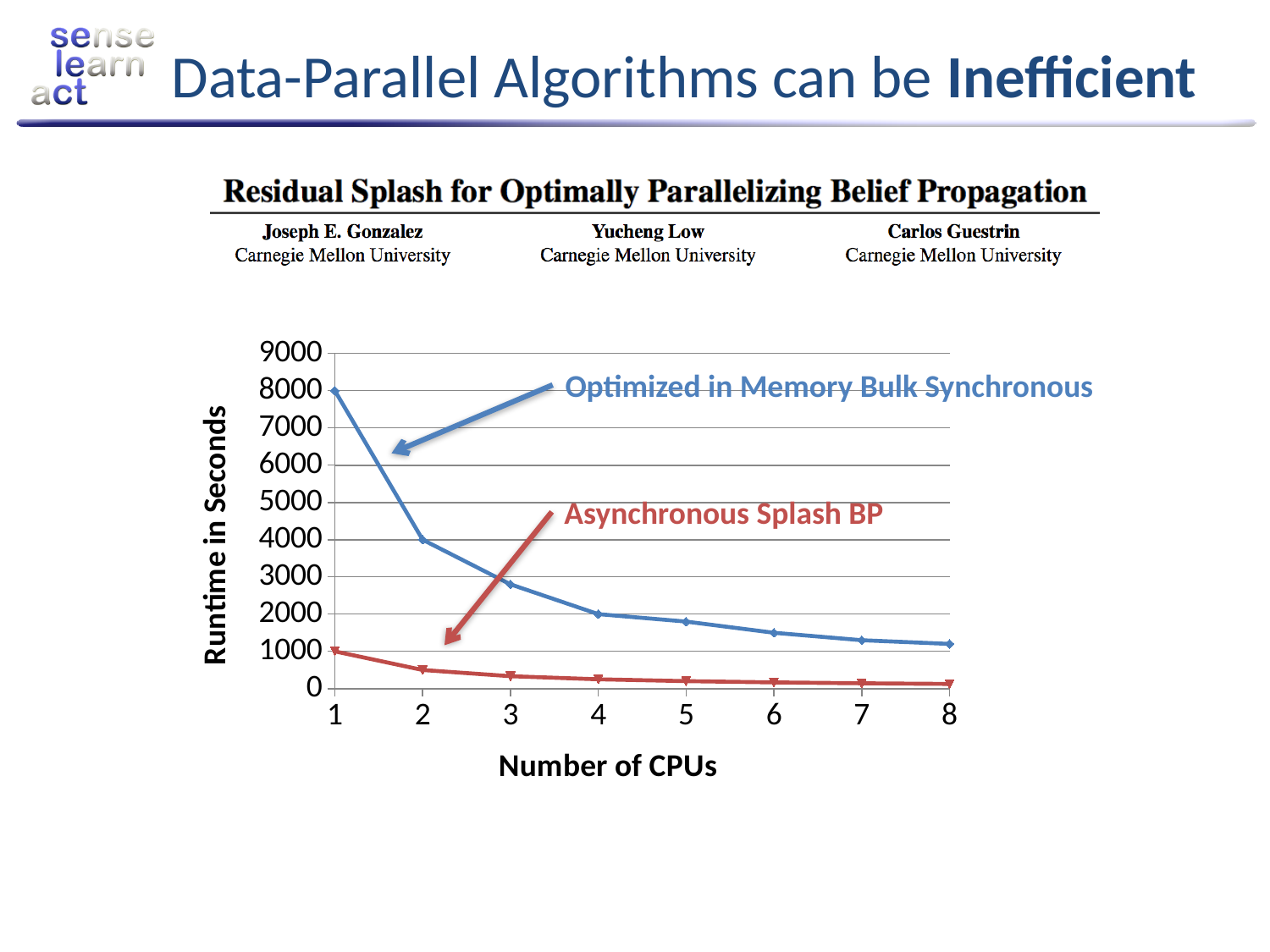
What kind of chart is shown on the slide? line chart Does the runtime for Optimized in Memory Bulk Synchronous rise or fall as the number of CPUs increases? fall How many CPU counts are shown along the x axis of the chart? 8 Is the runtime for Optimized in Memory Bulk Synchronous at 3 CPUs greater or less than 2000 seconds? greater What is the runtime in seconds for Optimized in Memory Bulk Synchronous at 1 CPU? 8000 Is the runtime for Asynchronous Splash BP at 2 CPUs greater or less than 1000 seconds? less At 4 CPUs, which series has the higher runtime, Optimized in Memory Bulk Synchronous or Asynchronous Splash BP? Optimized in Memory Bulk Synchronous How many data series are plotted in the chart? 2 At which number of CPUs is the runtime for Asynchronous Splash BP lowest? 8 Is the runtime for Optimized in Memory Bulk Synchronous at 8 CPUs greater or less than 2000 seconds? less What is the title of the y axis of the chart? Runtime in Seconds At which number of CPUs is the runtime for Optimized in Memory Bulk Synchronous highest? 1